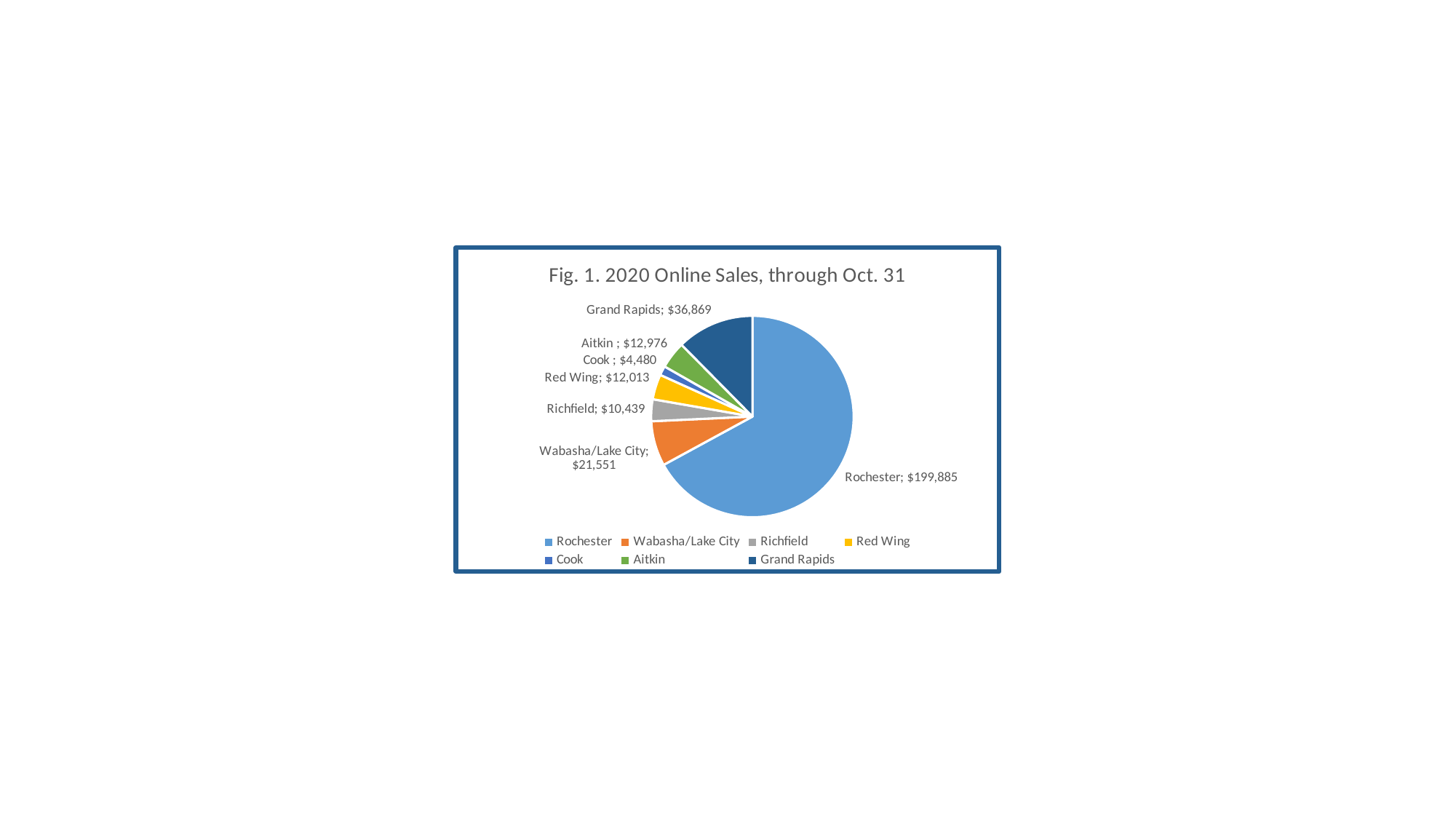
What type of chart is shown on the slide? Pie chart What is the difference between the Grand Rapids value and the Wabasha/Lake City value? $15,318 What is the title of the chart? Fig. 1. 2020 Online Sales, through Oct. 31 Which location has the largest slice of the pie? Rochester Which is larger, the value for Aitkin or the value for Red Wing? Aitkin What colour is the Rochester slice in the pie chart? Light blue Which location has the smallest slice of the pie? Cook Which is larger, the value for Richfield or the value for Cook? Richfield How many locations are shown in the pie chart? 7 What is the online sales value for Rochester? $199,885 What is the online sales value for Grand Rapids? $36,869 What is the online sales value for Cook? $4,480